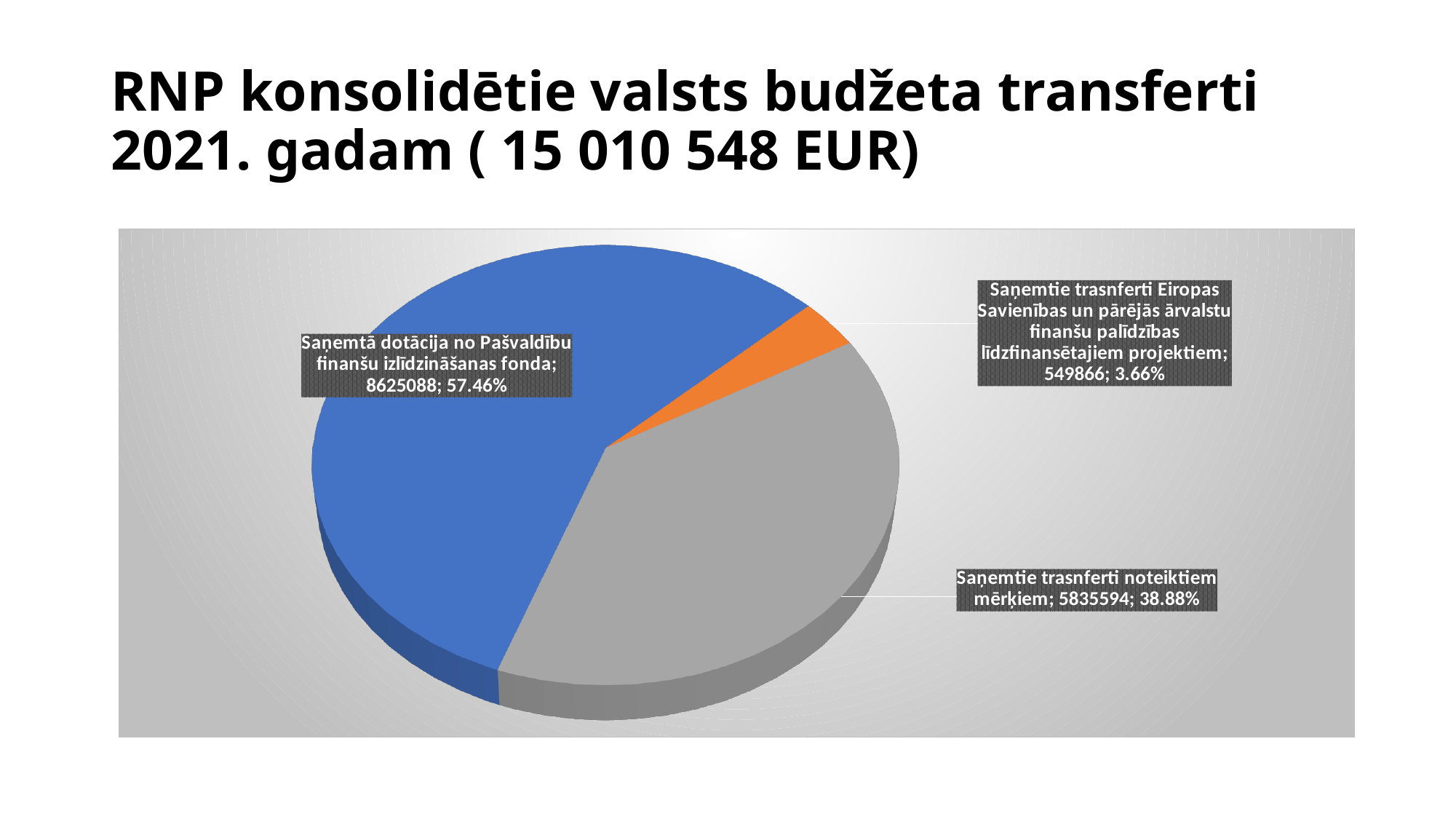
Which slice is the largest? Saņemtā dotācija no Pašvaldību finanšu izlīdzināšanas fonda How many slices does the pie chart have? 3 What share of the pie does "Saņemtā dotācija no Pašvaldību finanšu izlīdzināšanas fonda" represent? 57.46% What kind of chart is shown on the slide? pie chart What is the difference between the values for "Saņemtā dotācija no Pašvaldību finanšu izlīdzināšanas fonda" and "Saņemtie trasnferti noteiktiem mērķiem"? 2789494 What is the value for "Saņemtie trasnferti Eiropas Savienības un pārējās ārvalstu finanšu palīdzības līdzfinansētajiem projektiem"? 549866 What share of the pie does "Saņemtie trasnferti Eiropas Savienības un pārējās ārvalstu finanšu palīdzības līdzfinansētajiem projektiem" represent? 3.66% What is the value for "Saņemtie trasnferti noteiktiem mērķiem"? 5835594 Which slice is the smallest? Saņemtie trasnferti Eiropas Savienības un pārējās ārvalstu finanšu palīdzības līdzfinansētajiem projektiem What is the value for "Saņemtā dotācija no Pašvaldību finanšu izlīdzināšanas fonda"? 8625088 What share of the pie does "Saņemtie trasnferti noteiktiem mērķiem" represent? 38.88% What is the title of the chart on the slide? RNP konsolidētie valsts budžeta transferti 2021. gadam ( 15 010 548 EUR)